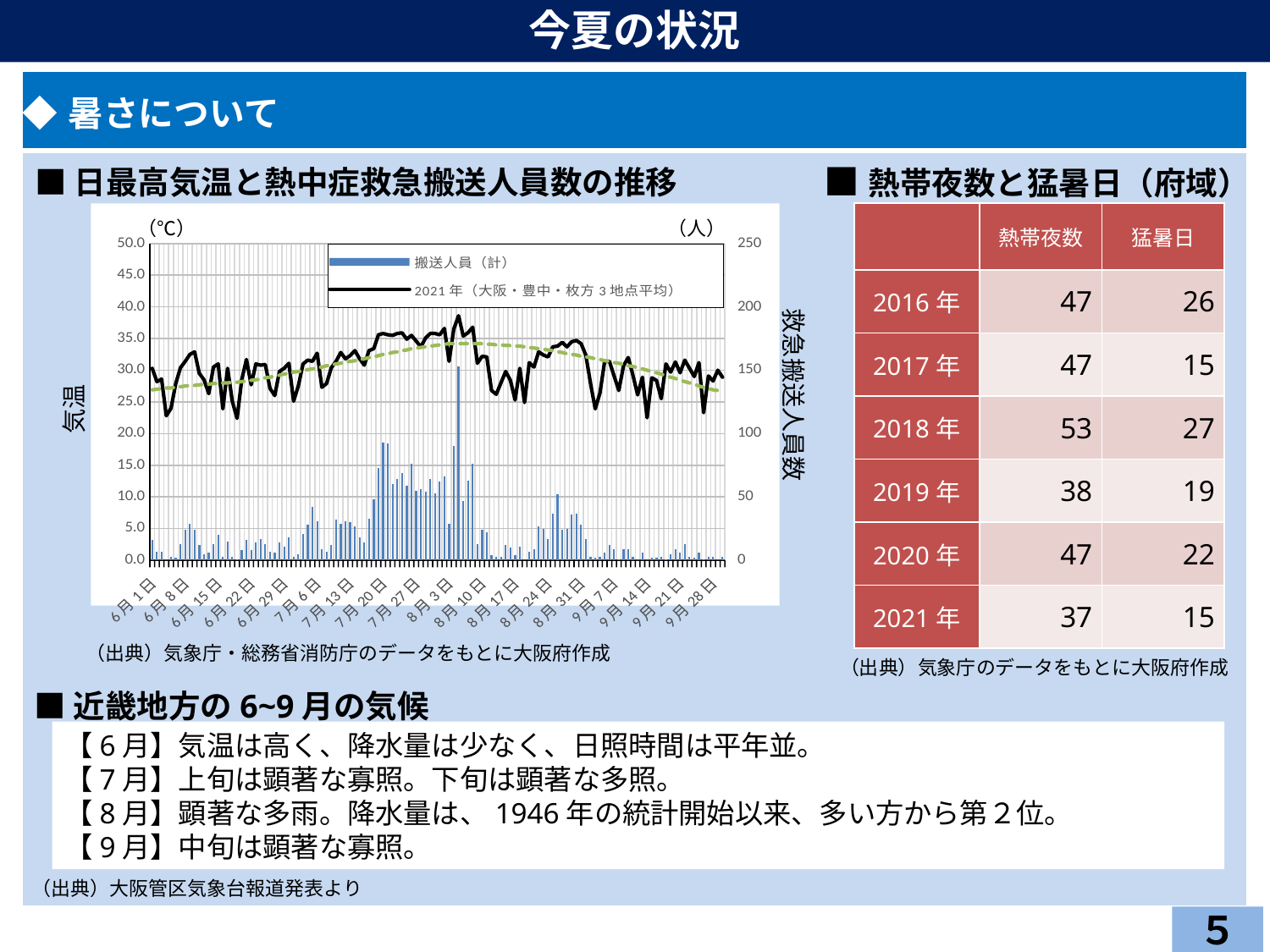
Is the lowest point of the 2021年 temperature line greater or less than 25.0℃? less Is the tallest bar for 搬送人員（計） greater or less than 200 on the right axis? less Does the 2021年 temperature line generally rise or fall from early 8月 to 9月28日? fall Does the 2021年 temperature line generally rise or fall from 6月1日 to early 8月? rise Is the tallest bar for 搬送人員（計） greater or less than 100 on the right axis? greater What unit is shown at the top of the left vertical axis of the chart? ℃ Which series in the chart is drawn as bars? 搬送人員（計） In which month does the tallest bar for 搬送人員（計） occur? 8月 How many series does the legend of the chart list? 2 How many date labels are shown along the x axis of the chart? 18 What kind of chart is shown under the heading 日最高気温と熱中症救急搬送人員数の推移? A combined bar and line chart